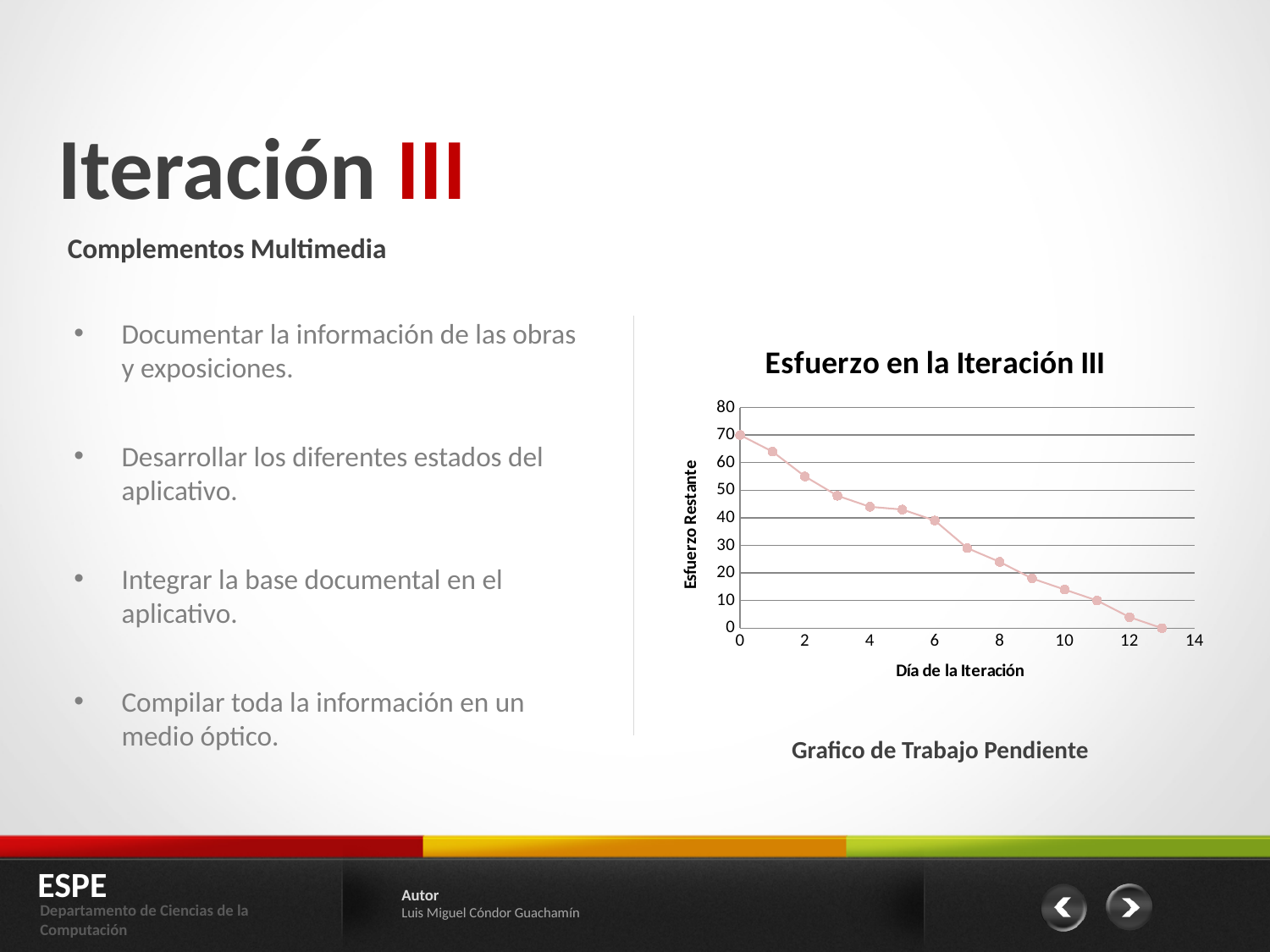
Is the value for day 4 greater or less than 40? greater Is the value for day 1 greater or less than 60? greater Which day has the lowest remaining effort in the chart? 13 Which day has the highest remaining effort in the chart? 0 What kind of chart is shown on the slide? line chart Is the value for day 2 greater or less than 50? greater Do the values in the chart rise or fall as the day of the iteration increases? fall What is the title of the chart? Esfuerzo en la Iteración III How many data points are plotted in the chart? 14 What is the label of the x axis of the chart? Día de la Iteración